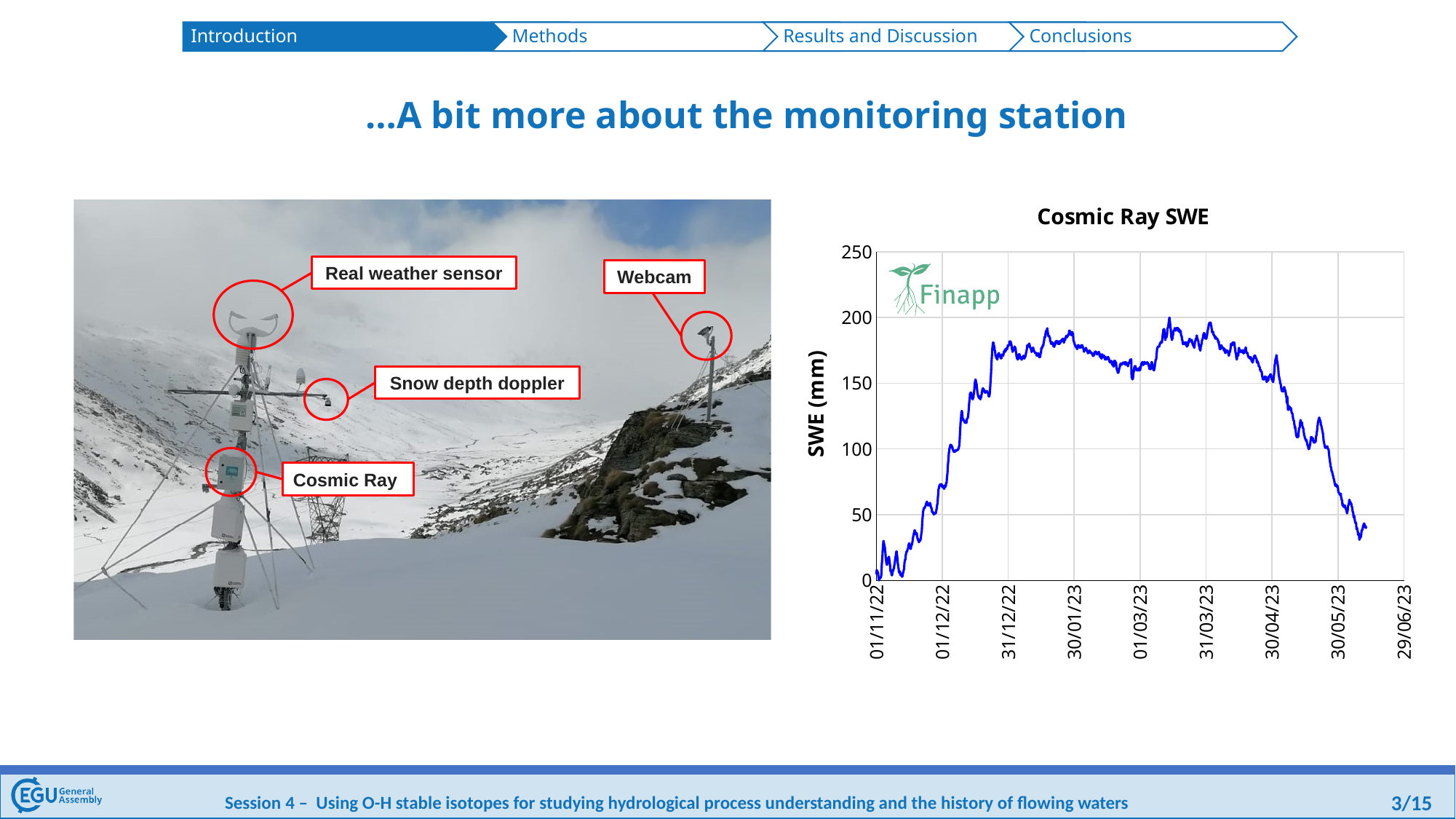
In the Cosmic Ray SWE chart, is the value at 01/11/22 greater or less than 50? less How many date labels are shown on the x axis of the Cosmic Ray SWE chart? 9 In the Cosmic Ray SWE chart, is the value at 31/12/22 greater or less than 150? greater In the Cosmic Ray SWE chart, is the value at 30/01/23 greater or less than 150? greater In the Cosmic Ray SWE chart, does the SWE rise or fall between 01/11/22 and 31/12/22? rise What is the title of the chart on the right of the slide? Cosmic Ray SWE What kind of chart is the Cosmic Ray SWE chart? line chart What is the first date label on the x axis of the Cosmic Ray SWE chart? 01/11/22 In the Cosmic Ray SWE chart, does the SWE rise or fall between 30/04/23 and 30/05/23? fall What is the highest tick value on the y axis of the Cosmic Ray SWE chart? 250 What is the label of the y axis of the Cosmic Ray SWE chart? SWE (mm)